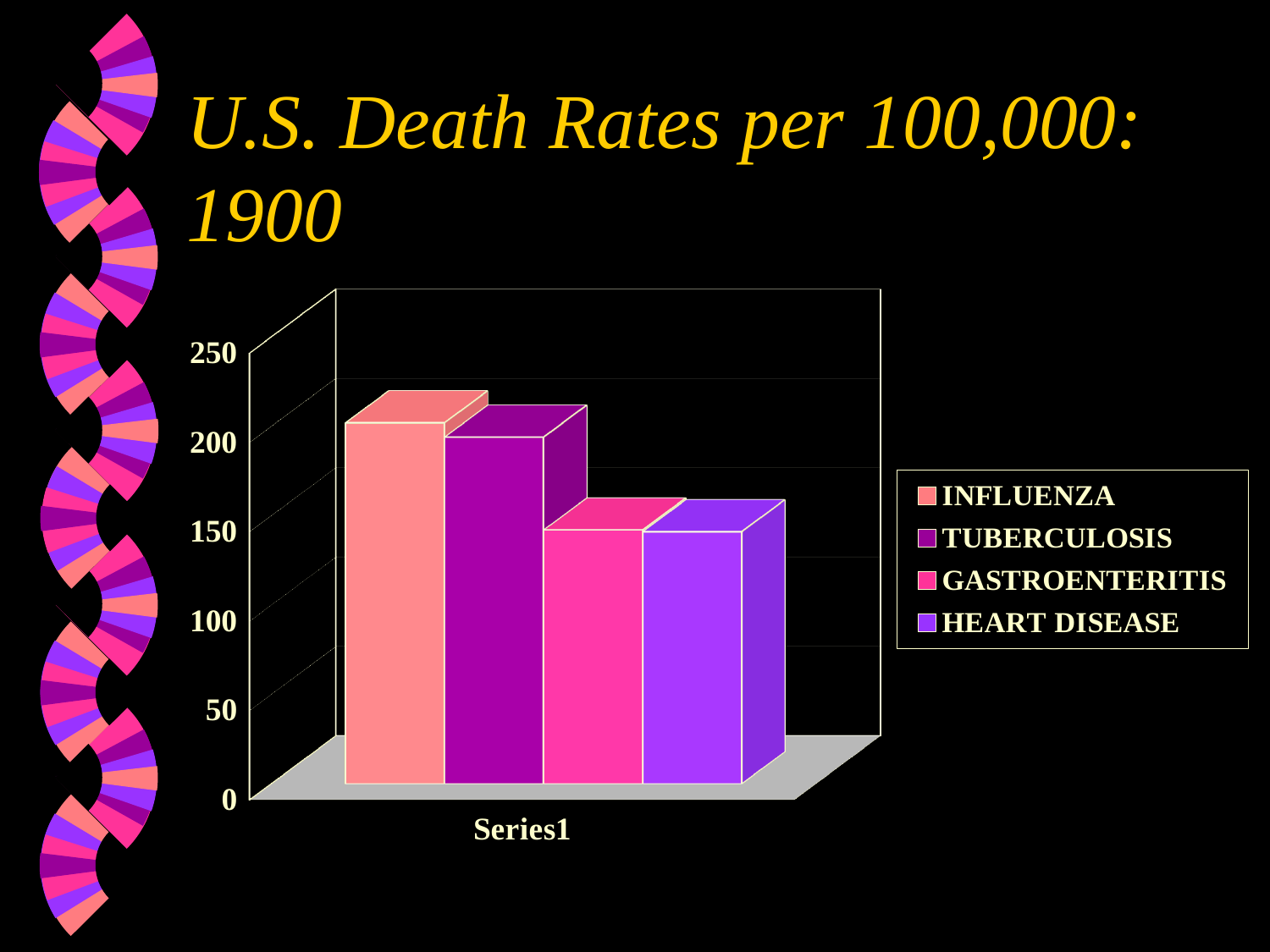
Which is larger, the death rate for TUBERCULOSIS or for HEART DISEASE? TUBERCULOSIS Which cause of death has the highest death rate in the chart? INFLUENZA Is the value for GASTROENTERITIS greater or less than 100? greater How many bars are plotted in the chart? 4 Do the bar values rise or fall from left to right across the chart? fall What is the title of the slide containing the chart? U.S. Death Rates per 100,000: 1900 What kind of chart is shown on the slide? bar chart How many entries does the chart's legend list? 4 Is the value for TUBERCULOSIS greater or less than 150? greater Is the value for HEART DISEASE greater or less than 200? less Which is larger, the death rate for INFLUENZA or for TUBERCULOSIS? INFLUENZA